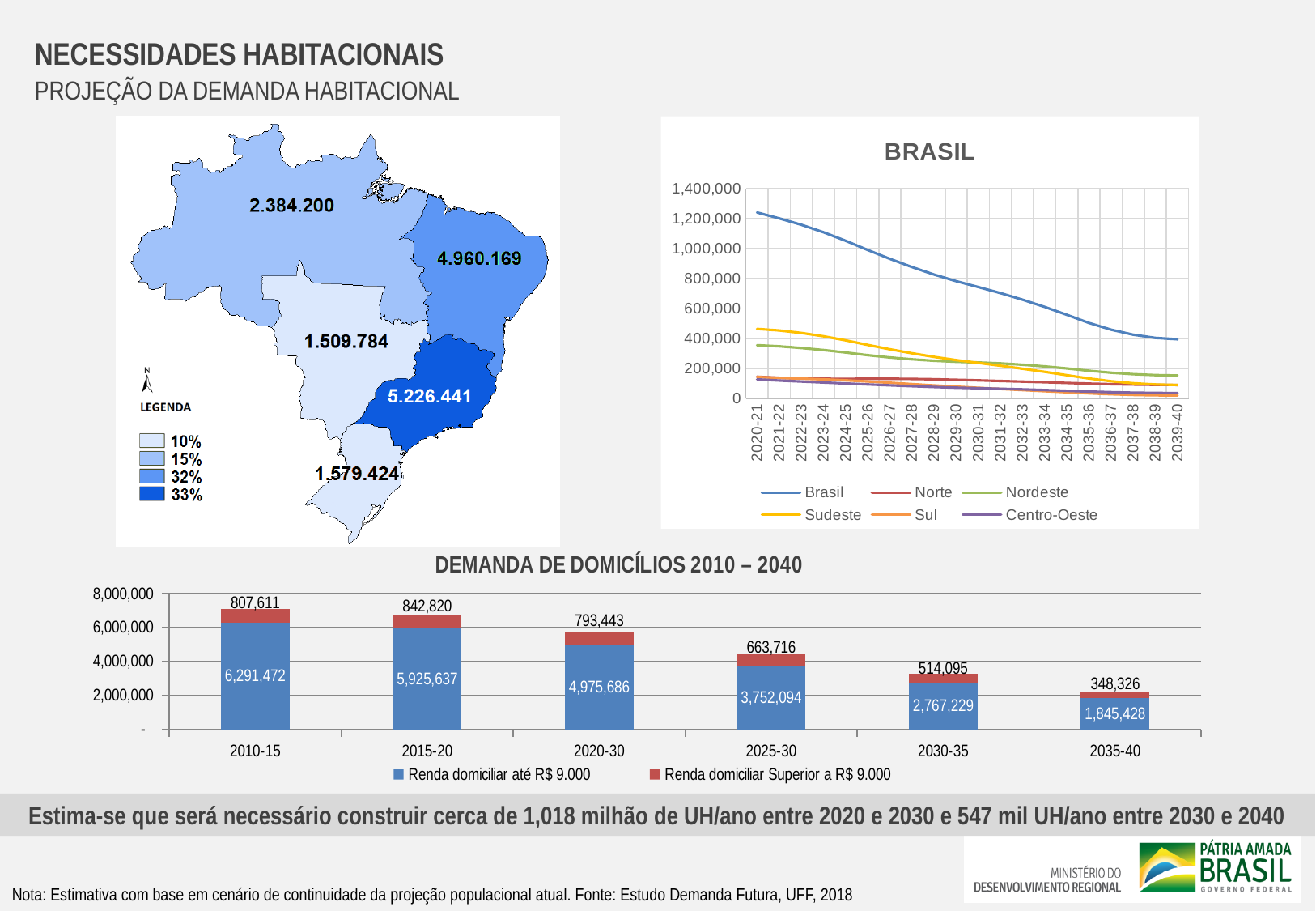
In the chart titled DEMANDA DE DOMICÍLIOS 2010 – 2040, what is the value for Renda domiciliar até R$ 9.000 in 2010-15? 6,291,472 In the chart titled BRASIL, is the value for Brasil in 2020-21 greater or less than 1,000,000? greater In the chart titled DEMANDA DE DOMICÍLIOS 2010 – 2040, what kind of chart is used? Stacked bar chart In the chart titled DEMANDA DE DOMICÍLIOS 2010 – 2040, how many periods are shown on the x axis? 6 In the chart titled DEMANDA DE DOMICÍLIOS 2010 – 2040, what is the total of the stacked bar for 2035-40? 2,193,754 In the chart titled BRASIL, is the value for Nordeste in 2020-21 greater or less than 400,000? less In the chart titled DEMANDA DE DOMICÍLIOS 2010 – 2040, which period has the lowest value for Renda domiciliar até R$ 9.000? 2035-40 In the chart titled DEMANDA DE DOMICÍLIOS 2010 – 2040, what is the value for Renda domiciliar Superior a R$ 9.000 in 2035-40? 348,326 In the chart titled BRASIL, does the Brasil line rise or fall from 2020-21 to 2039-40? Fall In the chart titled BRASIL, how many series does the legend list? 6 In the chart titled DEMANDA DE DOMICÍLIOS 2010 – 2040, which period has the highest value for Renda domiciliar Superior a R$ 9.000? 2015-20 In the chart titled DEMANDA DE DOMICÍLIOS 2010 – 2040, what is the difference between the Renda domiciliar até R$ 9.000 values for 2010-15 and 2015-20? 365,835